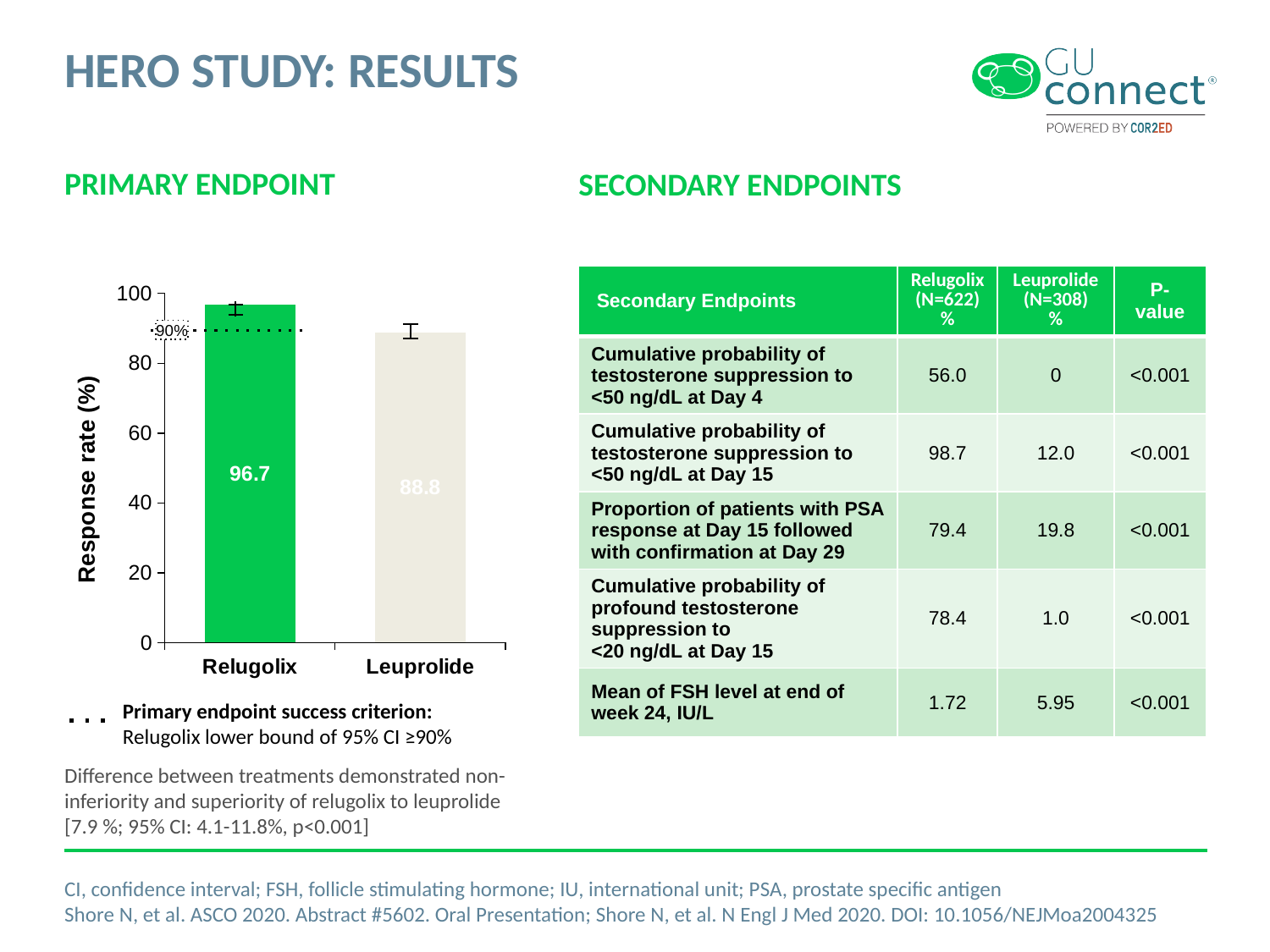
Is the response rate for Relugolix larger than that for Leuprolide in the bar chart? Yes Is the response rate for Leuprolide greater or less than 90 in the bar chart? less Is the response rate for Relugolix greater or less than 90 in the bar chart? greater What is the difference in response rate between Relugolix and Leuprolide in the bar chart? 7.9 What is the response rate for Relugolix in the bar chart? 96.7 Which treatment has the lower response rate in the bar chart? Leuprolide Which treatment has the higher response rate in the bar chart? Relugolix How many treatment categories are shown in the bar chart? 2 What value does the dotted horizontal line in the bar chart mark? 90% What is the response rate for Leuprolide in the bar chart? 88.8 What type of chart is used to show the primary endpoint? Bar chart What is the label of the y-axis in the bar chart? Response rate (%)